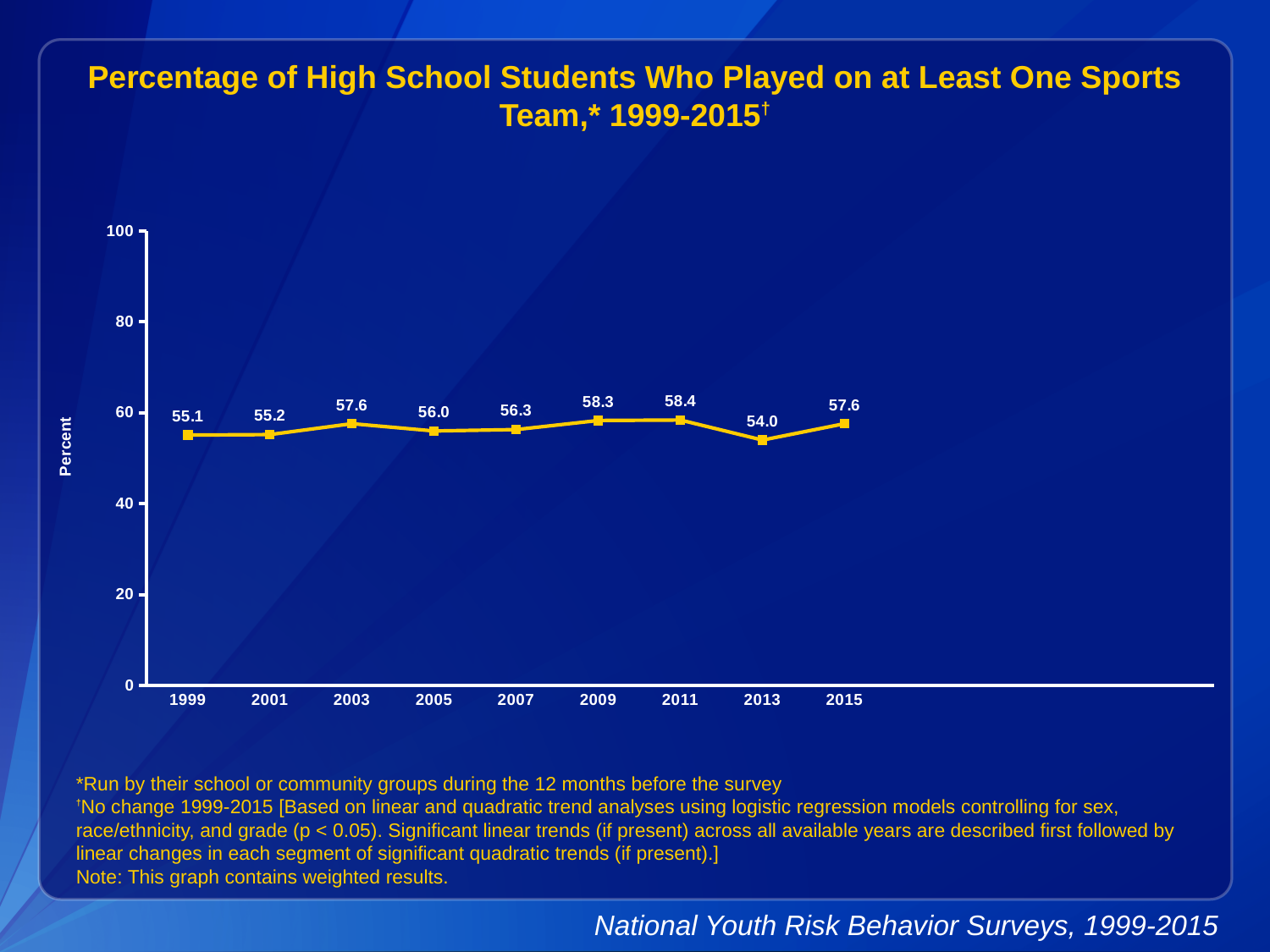
What is the difference between the 2015 value and the 1999 value? 2.5 What is the value plotted for 2013? 54.0 What is the label on the y axis? Percent What kind of chart is shown on the slide? line chart What is the value plotted for 2011? 58.4 What is the difference between the 2011 value and the 2013 value? 4.4 Which year has the larger value, 2003 or 2005? 2003 What percentage of high school students played on at least one sports team in 1999? 55.1 Is the value for 2009 greater or less than 40? greater How many years are plotted on the x axis? 9 Which year has the lowest value on the chart? 2013 Which year has the highest value on the chart? 2011